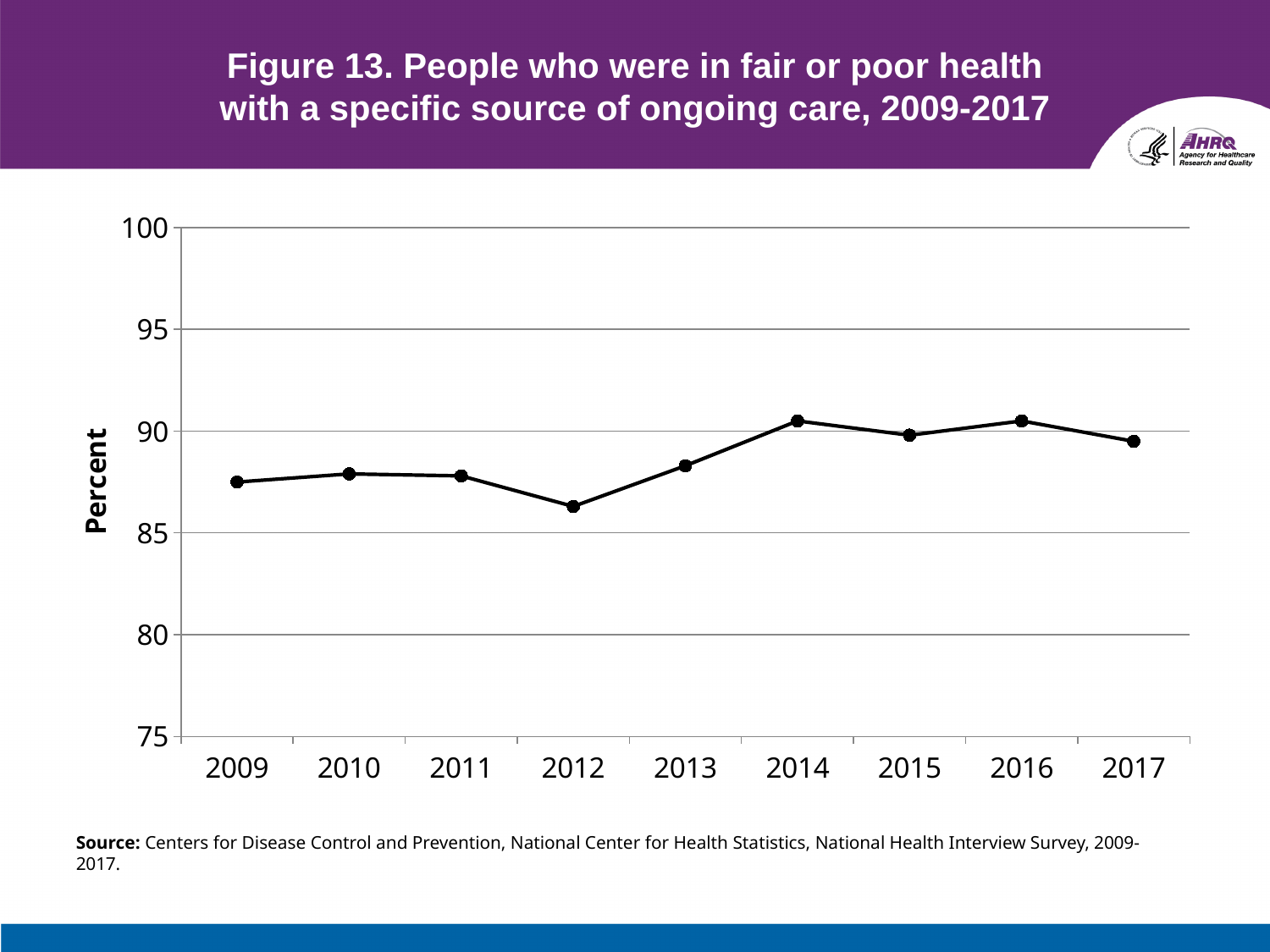
What is the lowest value shown on the vertical axis? 75 Is the value for 2015 greater or less than 95? less Which is larger, the value for 2014 or the value for 2012? 2014 What kind of chart is shown on the slide? line chart How many years (data points) are plotted on the chart? 9 Is the value for 2009 greater or less than 85? greater Which is larger, the value for 2013 or the value for 2012? 2013 What is the label on the vertical axis? Percent Is the value for 2013 greater or less than 90? less Do the values rise or fall from 2012 to 2014? rise Which year has the lowest value on the chart? 2012